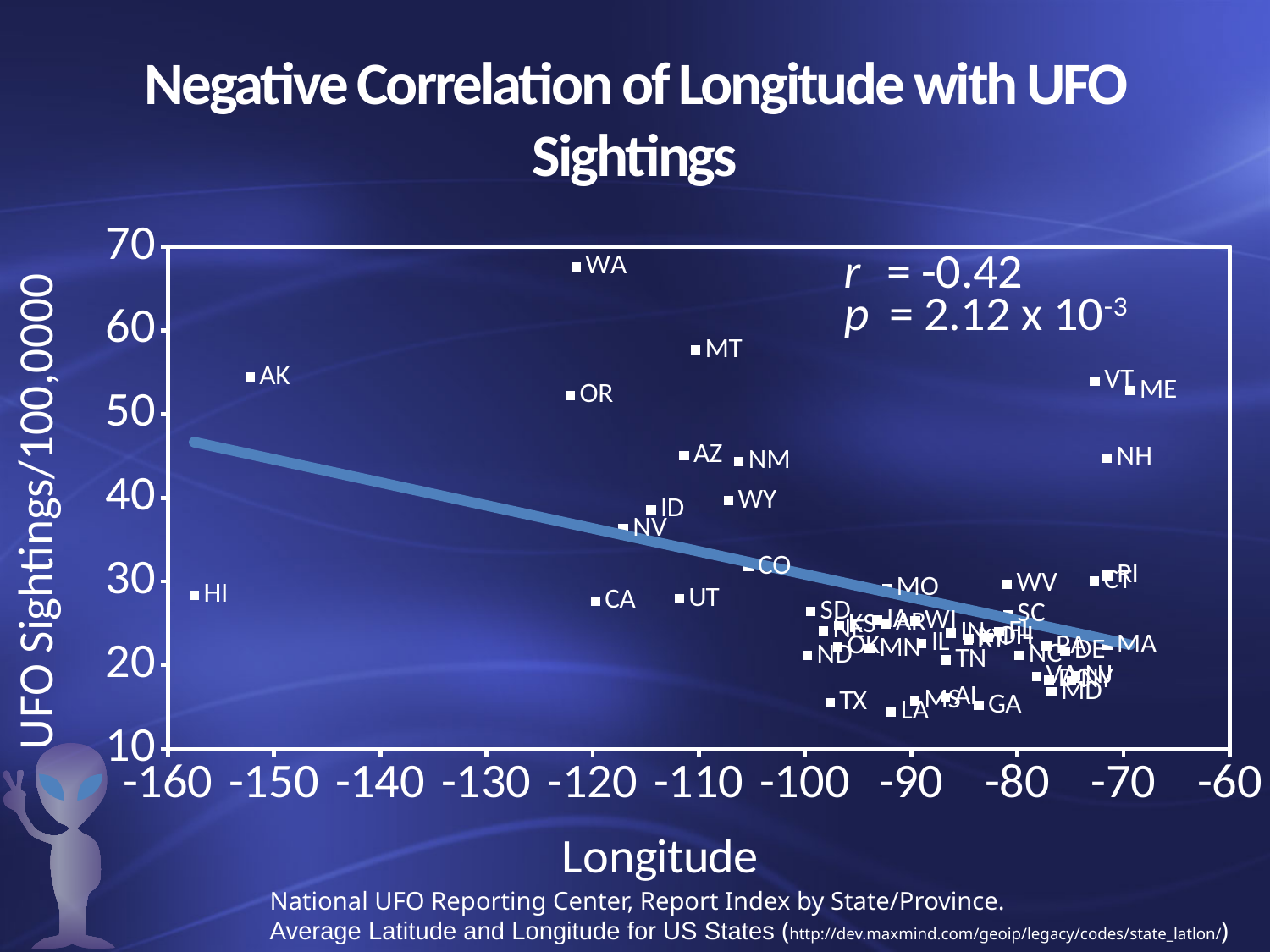
Is the value for AK greater or less than 50? greater Is the value for WA greater or less than 60? greater Do UFO sightings tend to rise or fall as longitude increases along the x axis? fall Is the value for TX greater or less than 20? less What is the title of the chart? Negative Correlation of Longitude with UFO Sightings What is the correlation coefficient r printed on the chart? -0.42 What p-value is printed on the chart? 2.12 x 10^-3 Which has more UFO sightings per 100,000, WA or MT? WA Which state has the highest UFO sightings per 100,000 on the chart? WA What kind of chart is shown on the slide? scatter plot Which has more UFO sightings per 100,000, NH or WV? NH